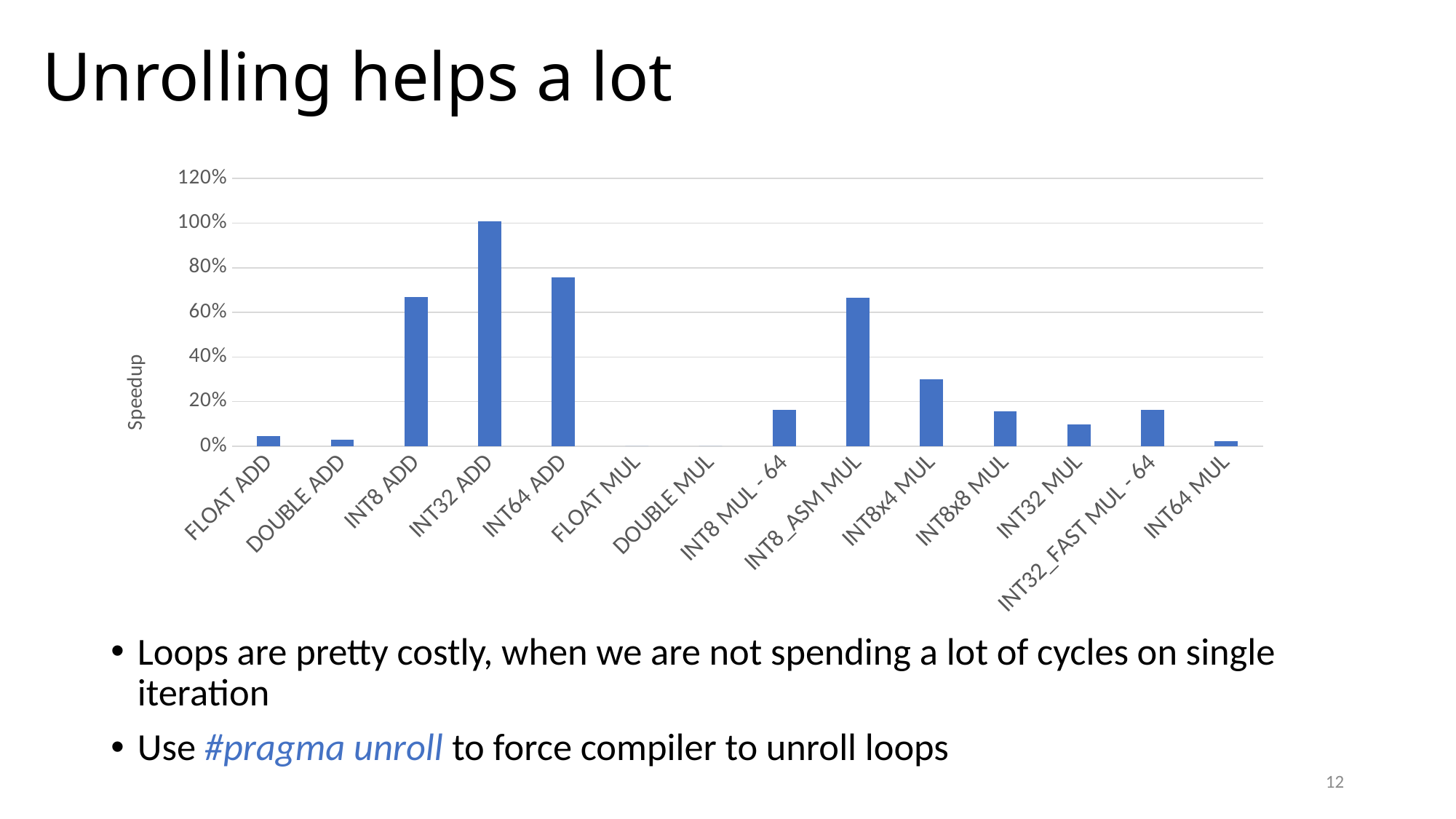
How many categories are plotted along the x axis of the chart? 14 Is the speedup for FLOAT ADD greater or less than 20%? less What is the label on the vertical axis of the chart? Speedup What kind of chart is shown on the slide? bar chart Is the speedup for INT8x4 MUL greater or less than 20%? greater Which has the larger speedup, INT32 ADD or INT64 ADD? INT32 ADD Is the speedup for INT32 MUL greater or less than 20%? less Which category has the highest speedup in the chart? INT32 ADD Which has the larger speedup, INT8x4 MUL or INT8x8 MUL? INT8x4 MUL